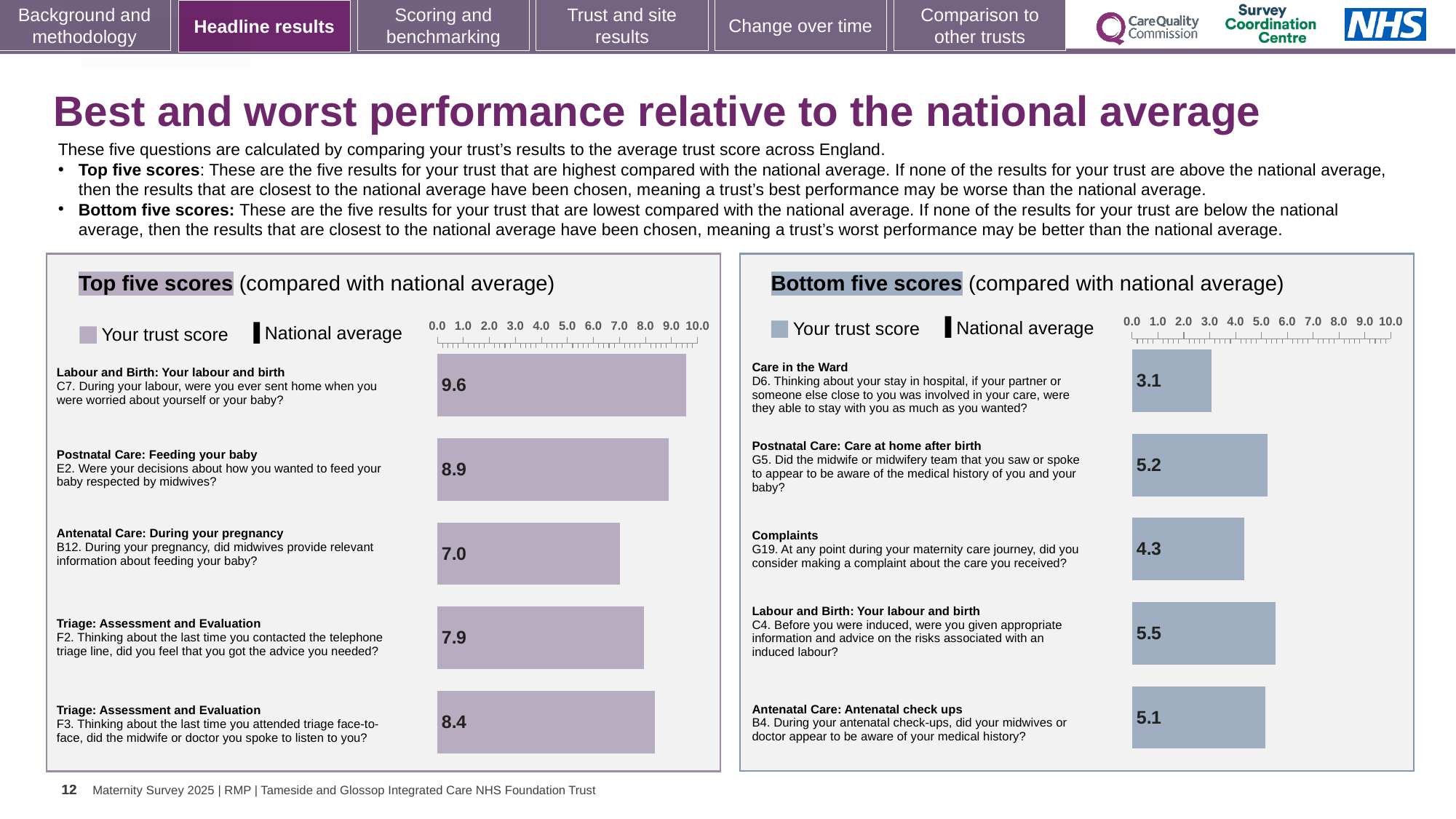
In the Bottom five scores chart, which question has the highest trust score? C4 (Labour and Birth: Your labour and birth) In the Top five scores chart, what is the trust score for question C7 (Labour and Birth: Your labour and birth)? 9.6 In the Bottom five scores chart, is the trust score for G19 greater or less than 5.0? less In the Top five scores chart, what is the difference between the trust scores for C7 and E2? 0.7 In the Top five scores chart, which has the larger trust score, F2 or F3? F3 In the Top five scores chart, which question has the highest trust score? C7 (Labour and Birth: Your labour and birth) In the Bottom five scores chart, what is the trust score for question D6 (Care in the Ward)? 3.1 In the Bottom five scores chart, which question has the lowest trust score? D6 (Care in the Ward) In the Bottom five scores chart, what is the difference between the trust scores for C4 and D6? 2.4 In the Top five scores chart, which question has the lowest trust score? B12 (Antenatal Care: During your pregnancy) What type of chart is used in the Top five scores panel? Bar chart How many bars are shown in the Bottom five scores chart? 5